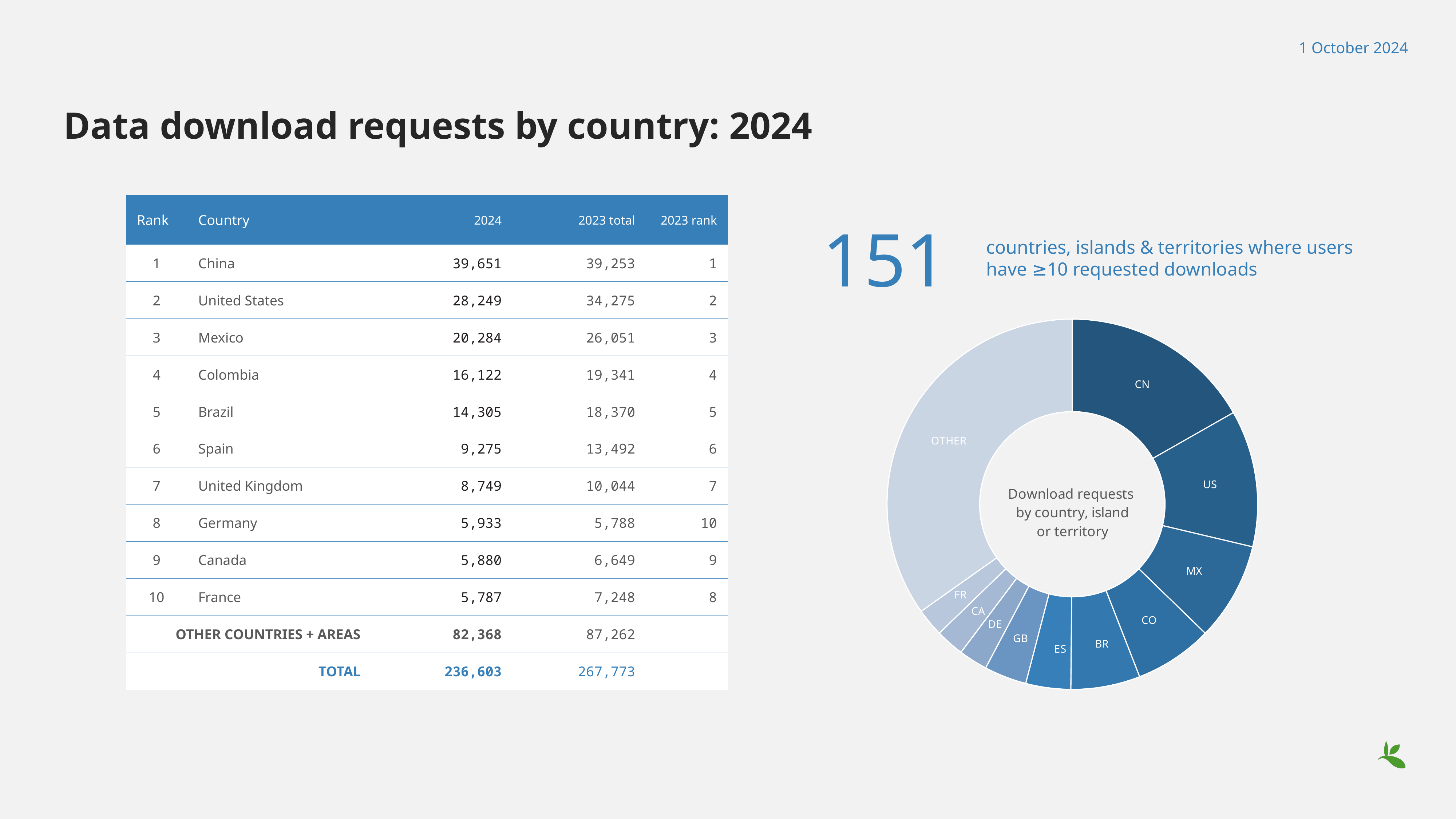
What is the difference between China's and the United States' 2024 download requests? 11,402 In the donut chart, is the CO slice larger or smaller than the GB slice? Larger How many download requests did China (CN) have in 2024, according to the slide? 39,651 Which slice of the donut chart is the largest? OTHER Which of the ten ranked countries has the fewest download requests in 2024? France What kind of chart is shown on the right of the slide? Donut (pie) chart What is the total number of download requests in 2024 shown on the slide? 236,603 How many slices does the donut chart have, including OTHER? 11 Among the individually labelled countries in the donut chart, which has the largest slice? CN How many download requests did Mexico (MX) have in 2024, according to the slide? 20,284 In the donut chart, is the US slice larger or smaller than the MX slice? Larger What is the title printed in the centre of the donut chart? Download requests by country, island or territory